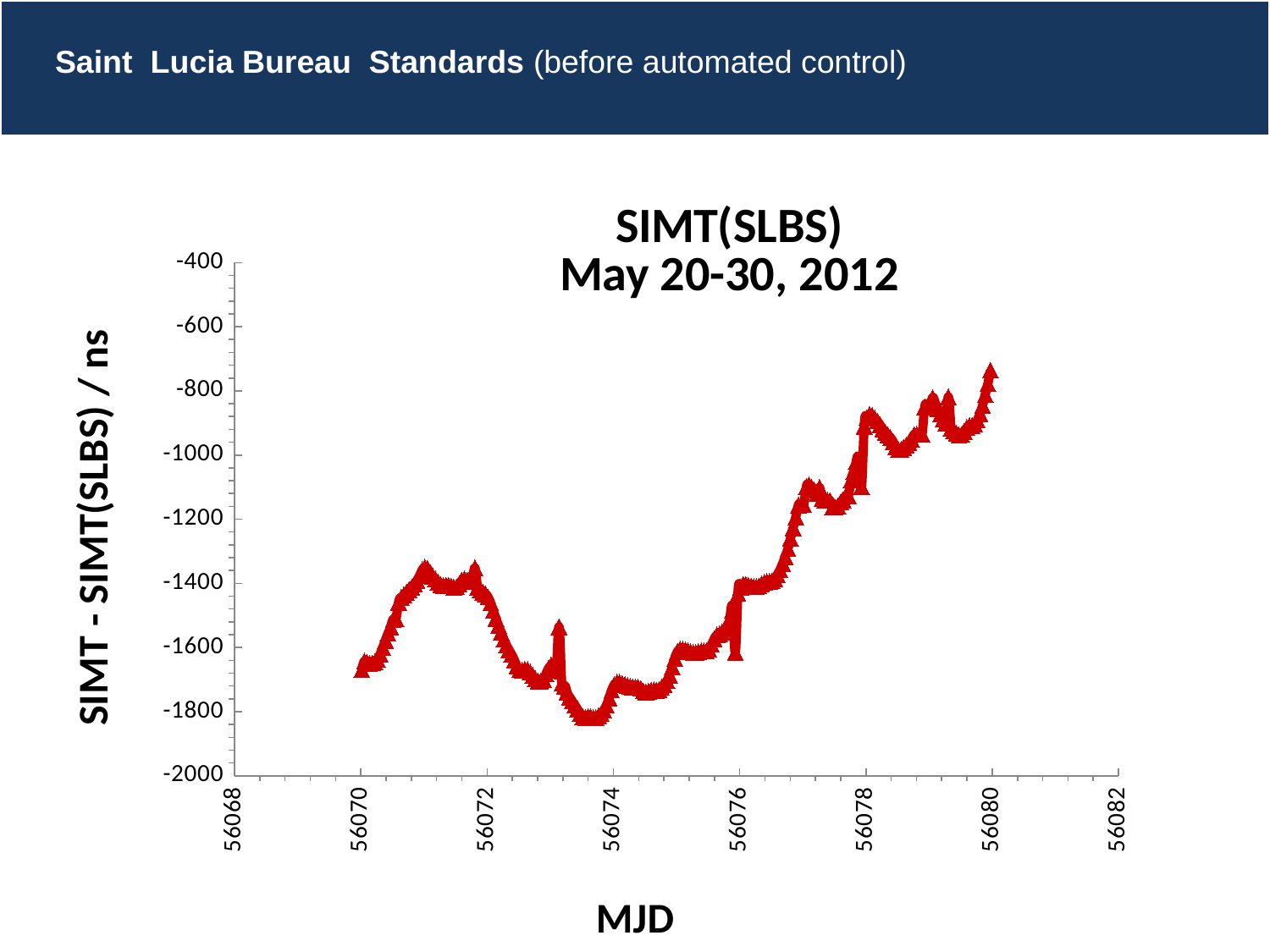
Is the highest value on the chart greater or less than -1000? greater Is the lowest value on the chart greater or less than -1600? less Is the value at MJD 56070 greater or less than -1600? less What kind of chart is shown on the slide? line chart Overall, do the values rise or fall from MJD 56070 to MJD 56080? rise Which is larger, the value at MJD 56078 or the value at MJD 56074? MJD 56078 What is the title of the chart? SIMT(SLBS) May 20-30, 2012 What is the label of the vertical axis? SIMT - SIMT(SLBS) / ns